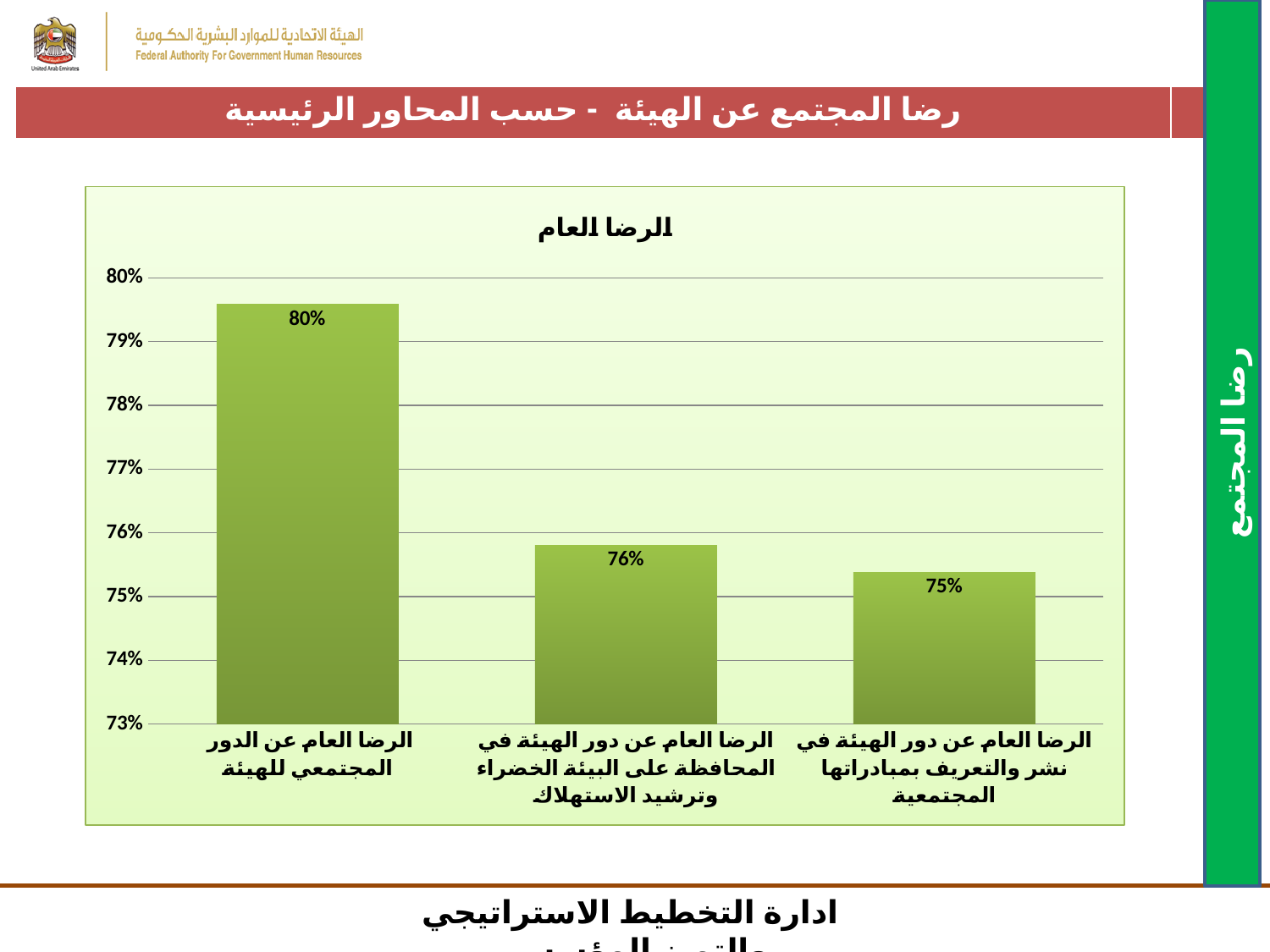
Which is larger: the value for "الرضا العام عن دور الهيئة في المحافظة على البيئة الخضراء وترشيد الاستهلاك" or the value for "الرضا العام عن دور الهيئة في نشر والتعريف بمبادراتها المجتمعية"? الرضا العام عن دور الهيئة في المحافظة على البيئة الخضراء وترشيد الاستهلاك What is the title of the chart? الرضا العام What kind of chart is shown on the slide? bar chart How many categories are shown in the chart? 3 What is the value for "الرضا العام عن دور الهيئة في نشر والتعريف بمبادراتها المجتمعية"? 75% What is the value for "الرضا العام عن دور الهيئة في المحافظة على البيئة الخضراء وترشيد الاستهلاك"? 76% Which category has the lowest value? الرضا العام عن دور الهيئة في نشر والتعريف بمبادراتها المجتمعية What is the value for "الرضا العام عن الدور المجتمعي للهيئة"? 80% What is the difference between the value for "الرضا العام عن الدور المجتمعي للهيئة" and the value for "الرضا العام عن دور الهيئة في نشر والتعريف بمبادراتها المجتمعية"? 5% Is the value for "الرضا العام عن الدور المجتمعي للهيئة" greater or less than 78%? greater Do the values rise or fall from left to right across the categories? fall Which category has the highest value? الرضا العام عن الدور المجتمعي للهيئة